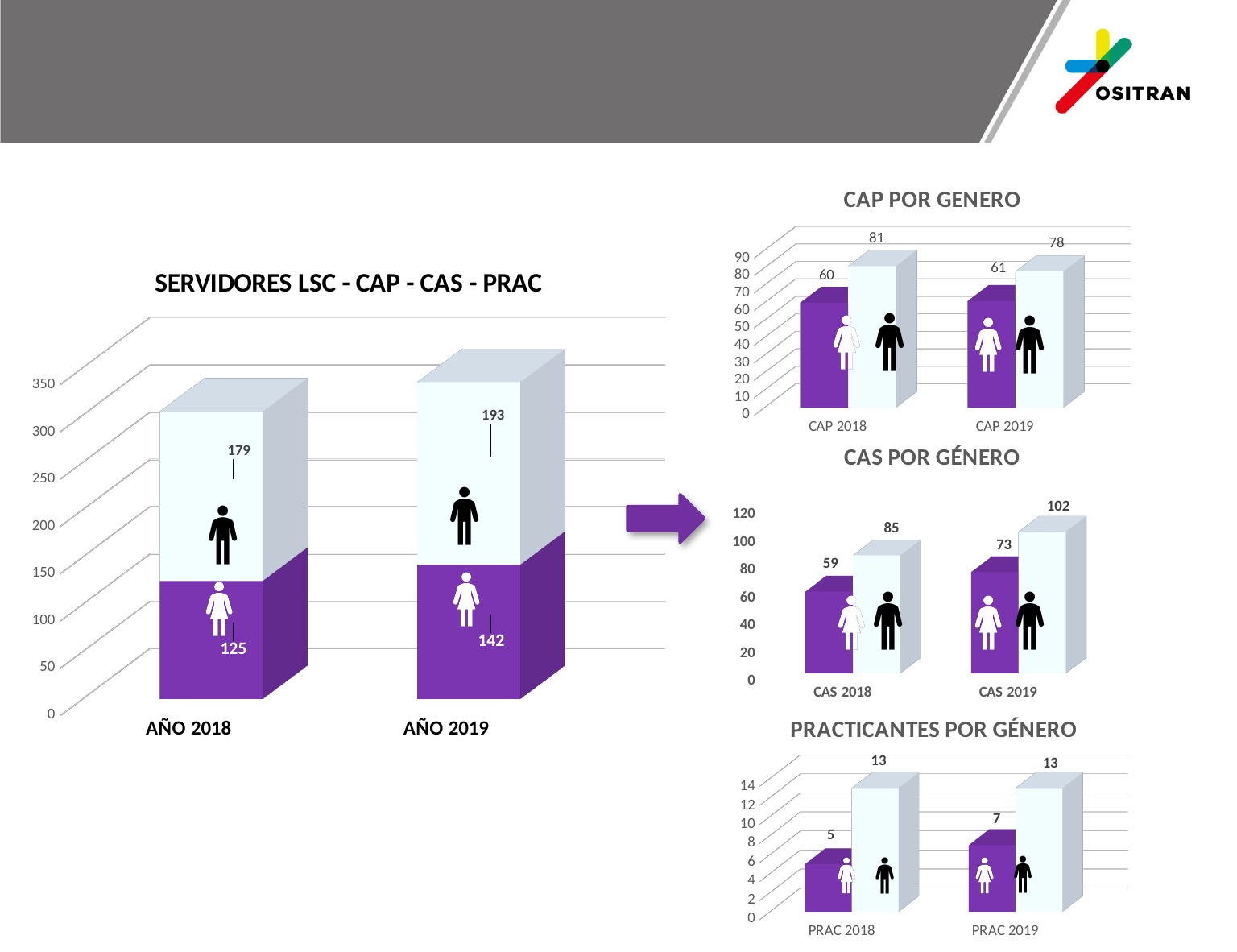
In the 'PRACTICANTES POR GÉNERO' chart, which bar is the lowest? PRAC 2018 purple (female icon) bar In the 'SERVIDORES LSC - CAP - CAS - PRAC' chart, what is the total of the stacked bar for AÑO 2018? 304 How many charts are shown on the slide? 4 In the 'CAP POR GENERO' chart, which is larger for CAP 2019: the purple (female icon) bar or the light (male icon) bar? the light (male icon) bar In the 'SERVIDORES LSC - CAP - CAS - PRAC' chart, what is the total of the stacked bar for AÑO 2019? 335 In the 'CAS POR GÉNERO' chart, what is the value of the light (male icon) bar for CAS 2019? 102 In the 'SERVIDORES LSC - CAP - CAS - PRAC' chart, what is the value of the light (male icon) segment for AÑO 2019? 193 In the 'CAS POR GÉNERO' chart, what is the difference between the purple (female icon) bars for CAS 2019 and CAS 2018? 14 In the 'PRACTICANTES POR GÉNERO' chart, what is the value of the purple (female icon) bar for PRAC 2018? 5 In the 'CAP POR GENERO' chart, what is the value of the light (male icon) bar for CAP 2018? 81 In the 'SERVIDORES LSC - CAP - CAS - PRAC' chart, what is the value of the purple (female icon) segment for AÑO 2018? 125 In the 'SERVIDORES LSC - CAP - CAS - PRAC' chart, what is the difference between the male-icon segments for AÑO 2019 and AÑO 2018? 14